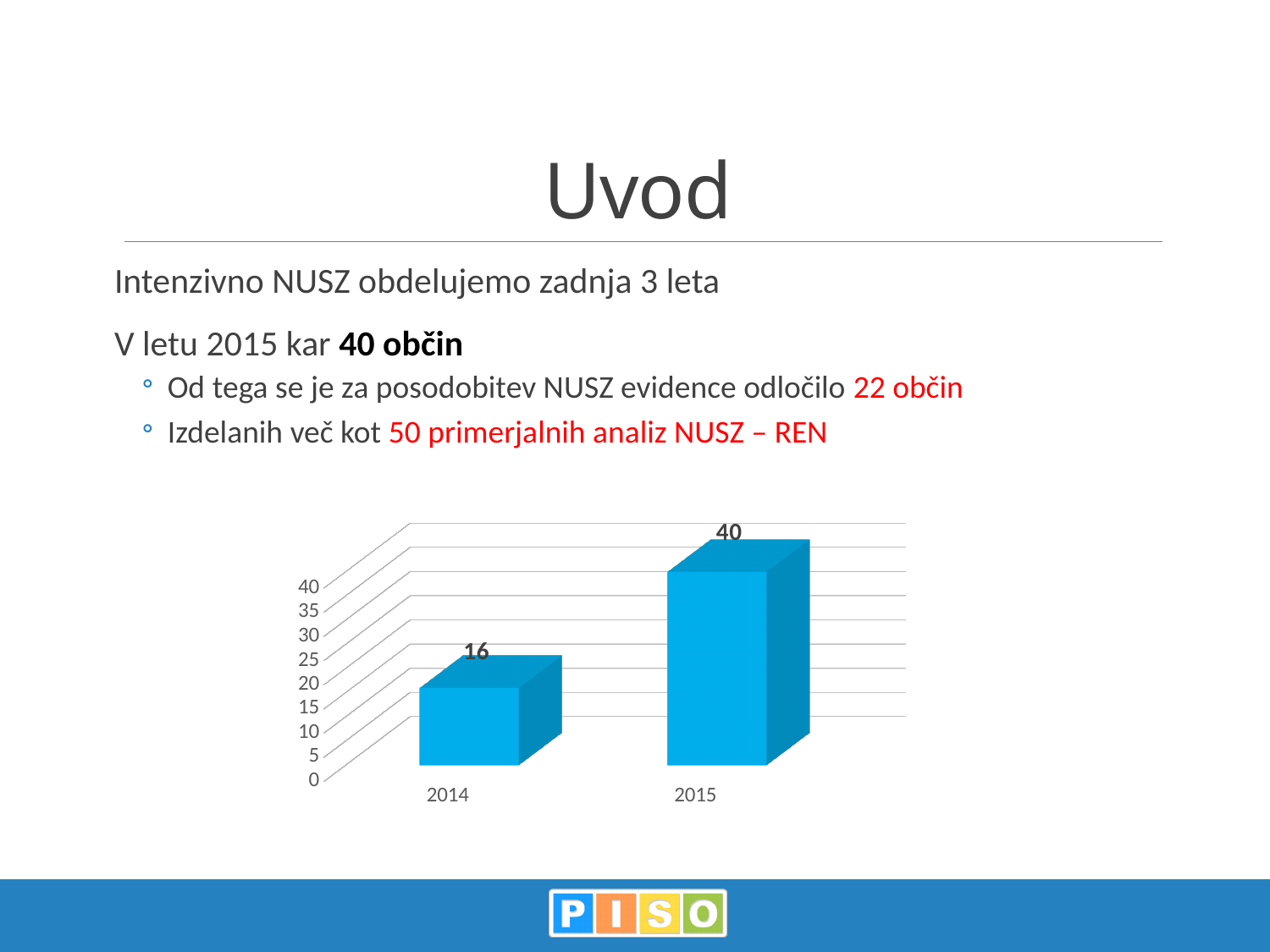
What kind of chart is shown on the slide? bar chart How many categories are shown on the x axis of the chart? 2 What is the difference between the values for 2015 and 2014? 24 What is the value for 2014 in the chart? 16 What is the value for 2015 in the chart? 40 Do the values rise or fall from 2014 to 2015? rise Which is larger, the value for 2014 or the value for 2015? 2015 Is the value for 2014 greater or less than 20? less What is the highest tick value shown on the vertical axis of the chart? 40 Which year has the lowest value in the chart? 2014 Is the value for 2015 greater or less than 30? greater Which year has the highest value in the chart? 2015